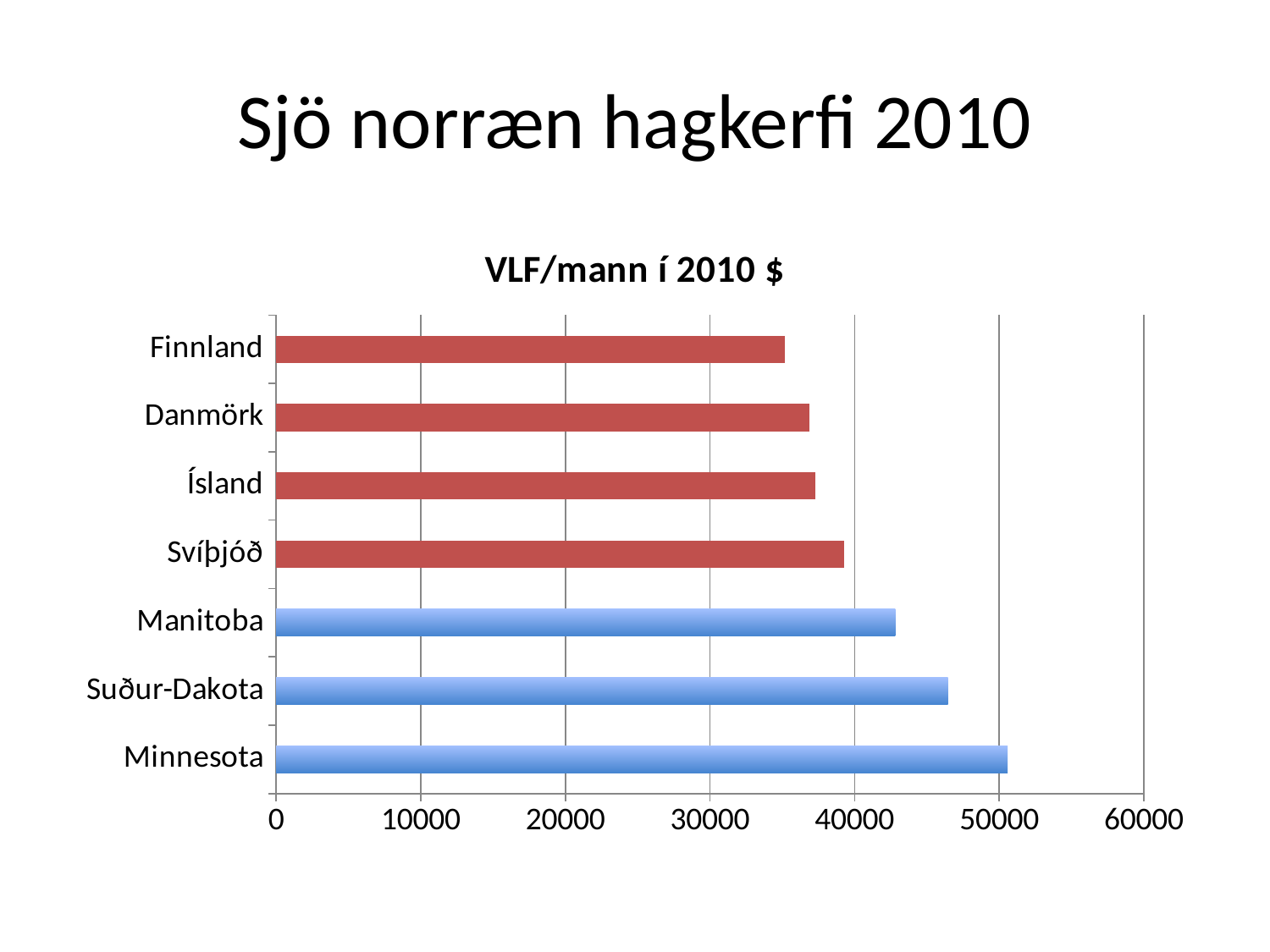
Is the value for Danmörk greater or less than 40000? less Which category has the lowest value? Finnland What kind of chart is shown on the slide? bar chart Is the value for Suður-Dakota greater or less than 50000? less What is the title of the chart? VLF/mann í 2010 $ How many categories are plotted in the chart? 7 Is the value for Minnesota greater or less than 40000? greater Which is larger, the value for Suður-Dakota or the value for Manitoba? Suður-Dakota Which category has the highest value? Minnesota Which is larger, the value for Svíþjóð or the value for Minnesota? Minnesota